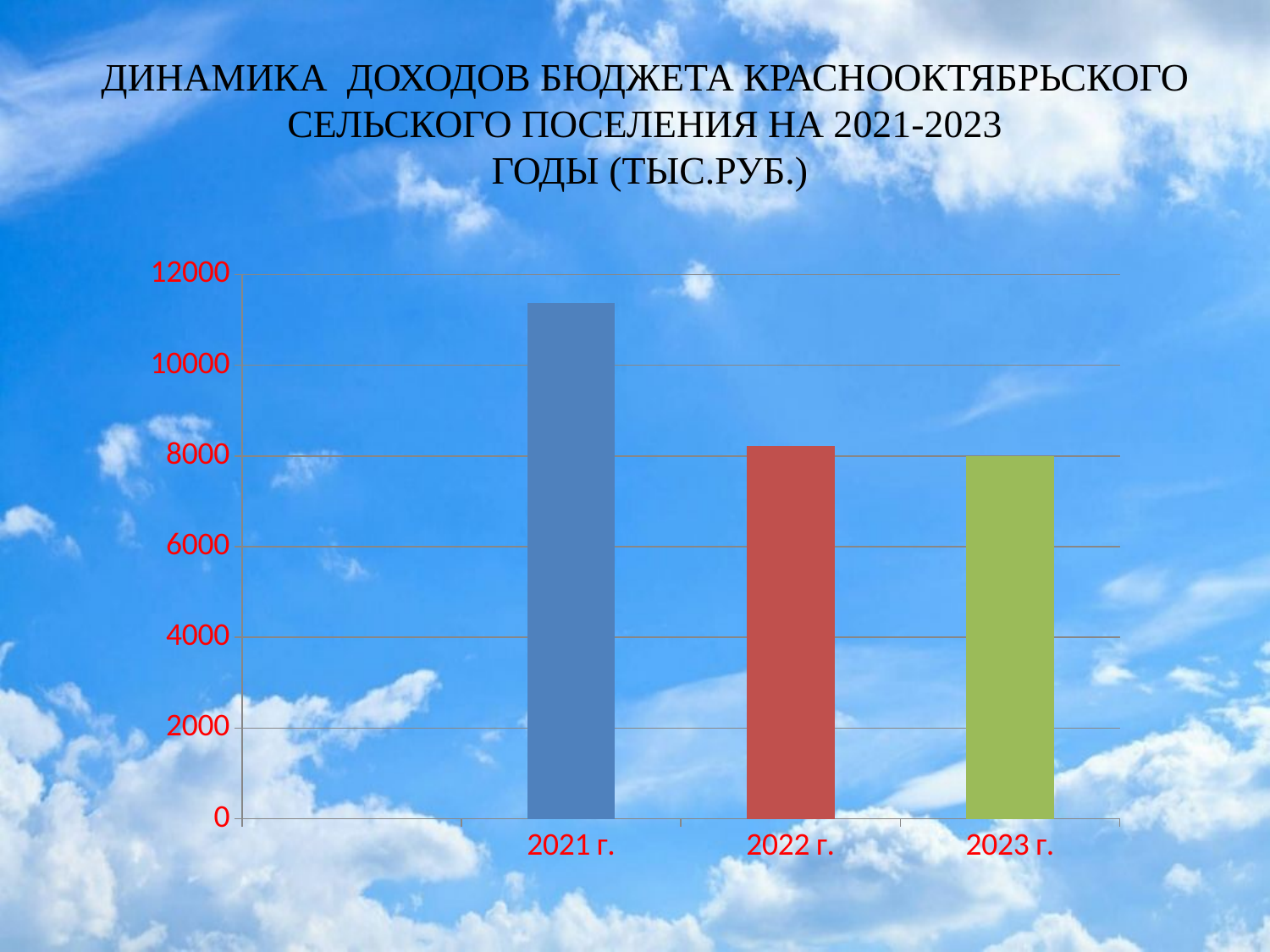
Is the value for 2022 г. greater or less than 6000? greater Is the value for 2021 г. greater or less than 10000? greater Which year has the highest budget income in the chart? 2021 г. Is the value for 2023 г. greater or less than 10000? less What kind of chart is shown on the slide? bar chart Do the values rise or fall from 2021 г. to 2023 г. along the x axis? fall What colour is the bar for 2022 г.? red Which is larger, the value for 2021 г. or the value for 2023 г.? 2021 г. How many years (categories) are shown on the x axis of the chart? 3